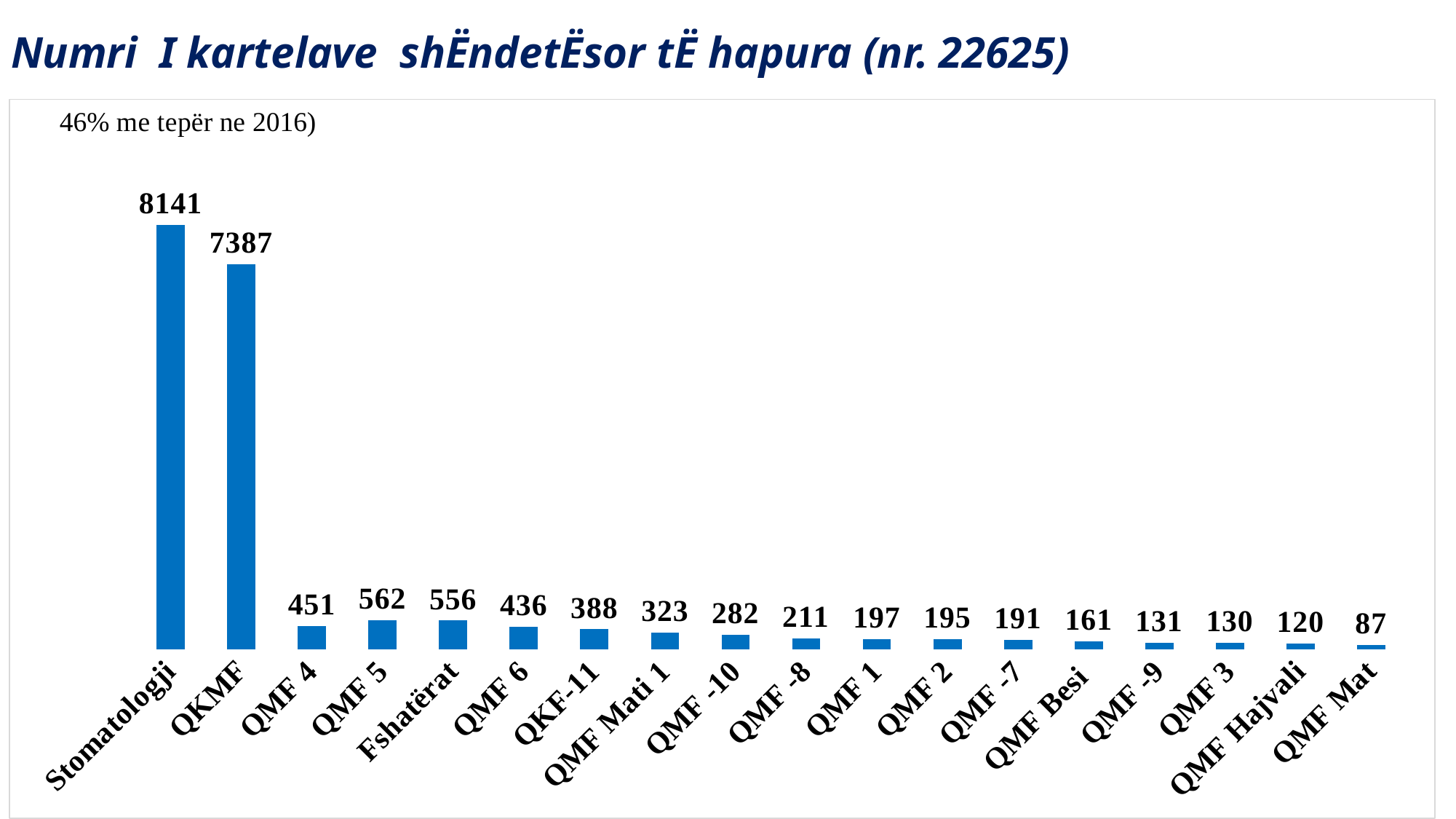
What kind of chart is shown on the slide? Bar chart What total number is given in parentheses in the slide title? 22625 Which category has the lowest value? QMF Mat What is the value for QMF Hajvali? 120 Which category has the highest value? Stomatologji How many categories are shown on the x axis? 18 What is the difference between the values for QMF 5 and QMF 4? 111 What is the value for Fshatërat? 556 Which is larger, the value for QMF 6 or the value for QKF-11? QMF 6 What is the value for Stomatologji? 8141 What is the difference between the values for Stomatologji and QKMF? 754 What is the value for QKMF? 7387